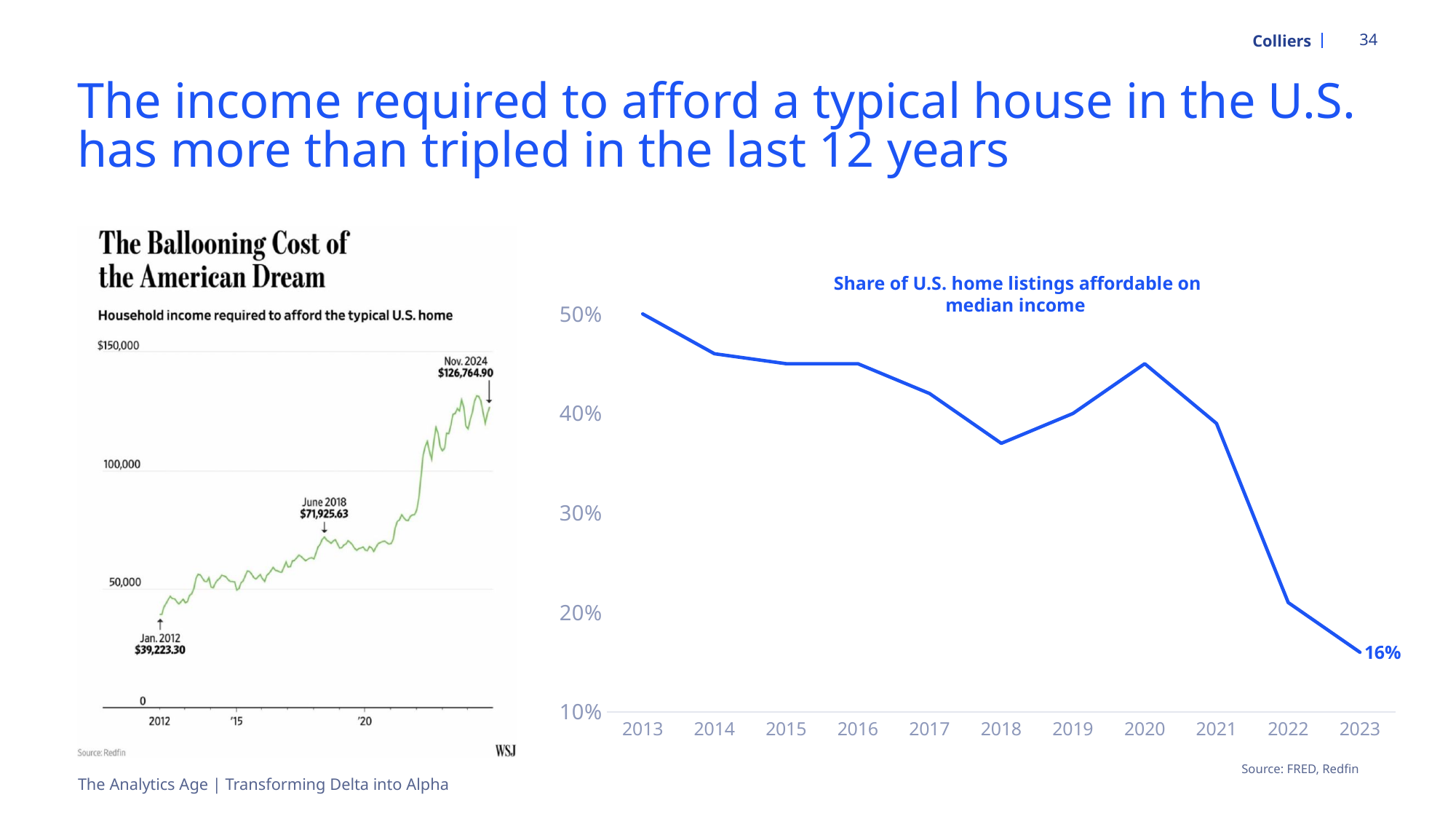
In the 'Share of U.S. home listings affordable on median income' chart, which year has the highest value? 2013 In the 'Share of U.S. home listings affordable on median income' chart, what is the value for 2023? 16% In the 'Share of U.S. home listings affordable on median income' chart, is the value for 2018 greater or less than 40%? less In the 'The Ballooning Cost of the American Dream' chart on the left, what household income is labeled for Nov. 2024? $126,764.90 In the 'Share of U.S. home listings affordable on median income' chart, which year has the lowest value? 2023 In the 'Share of U.S. home listings affordable on median income' chart, which year has a higher value, 2020 or 2021? 2020 In the 'The Ballooning Cost of the American Dream' chart on the left, what is the difference between the Nov. 2024 value and the Jan. 2012 value? $87,541.60 In the 'Share of U.S. home listings affordable on median income' chart, is the value for 2013 greater or less than 40%? greater What kind of chart is the 'Share of U.S. home listings affordable on median income' chart on the right? line chart In the 'The Ballooning Cost of the American Dream' chart on the left, what household income is labeled for Jan. 2012? $39,223.30 In the 'Share of U.S. home listings affordable on median income' chart, do the values generally rise or fall from 2013 to 2023? fall How many years are shown on the x axis of the 'Share of U.S. home listings affordable on median income' chart? 11